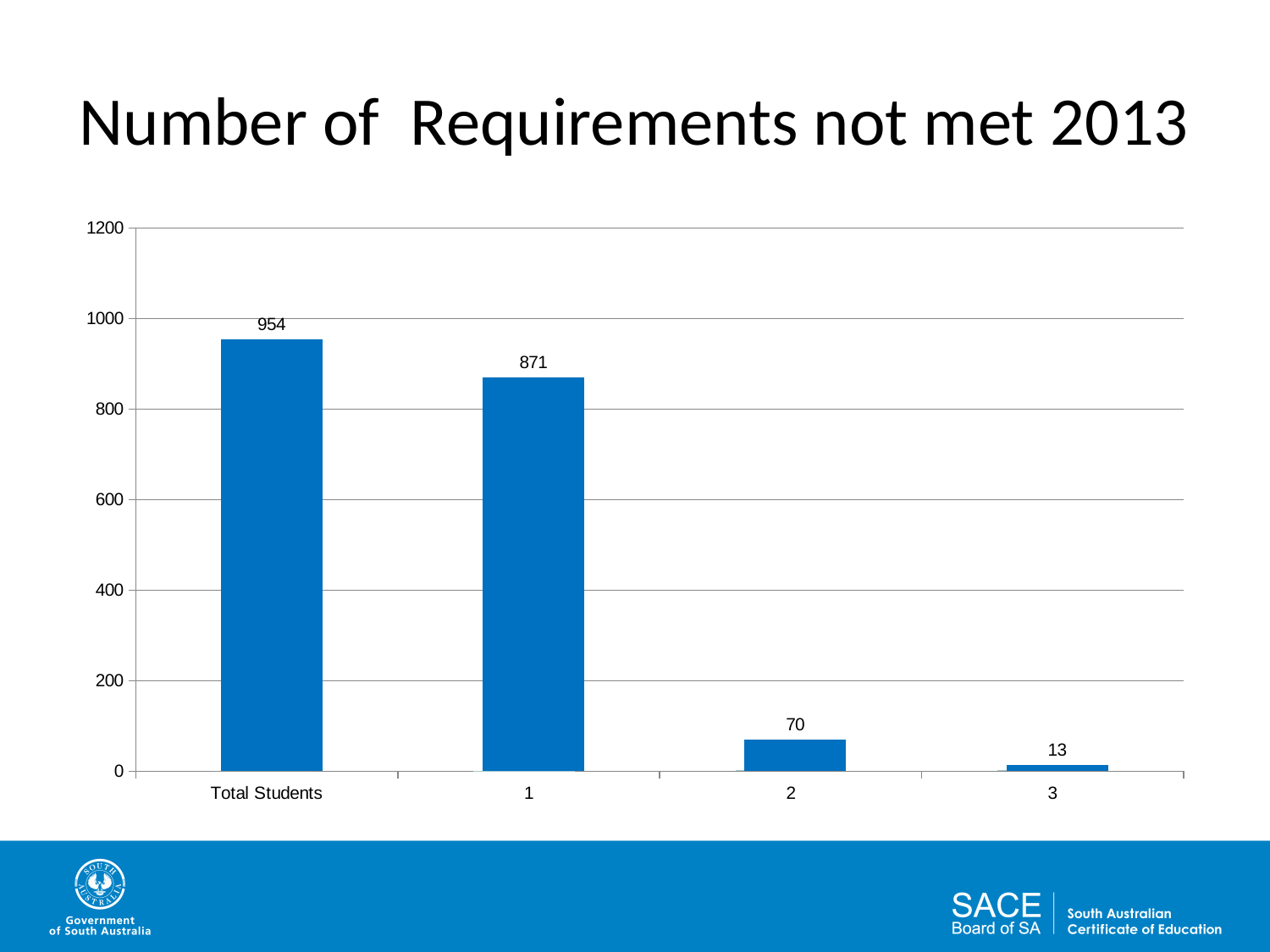
Which category has the lowest value? 3 What kind of chart is shown on the slide? bar chart Which category has the highest value? Total Students What is the difference between the values for Total Students and category 1? 83 What is the value for Total Students? 954 What is the value for category 1? 871 What is the value for category 2? 70 What is the title of the chart? Number of Requirements not met 2013 Which is larger, the value for category 1 or the value for category 2? 1 What is the value for category 3? 13 What is the difference between the values for category 2 and category 3? 57 How many categories are shown on the x axis? 4